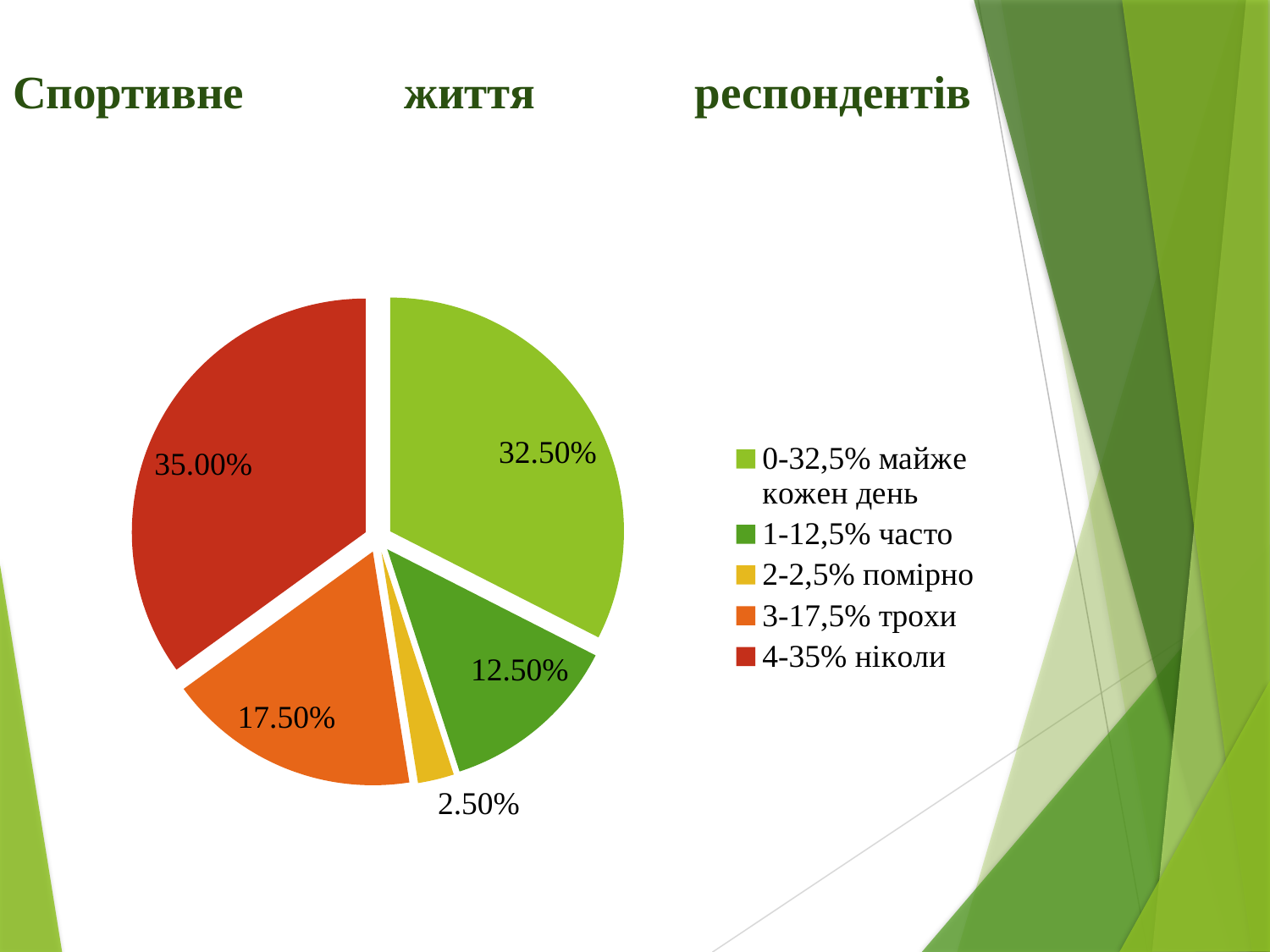
What kind of chart is shown on the slide? pie chart Which category has the largest slice of the pie? ніколи What is the difference between the "ніколи" slice and the "майже кожен день" slice? 2.50% What is the title of the slide containing the chart? Спортивне життя респондентів What is the value of the slice for "часто" (often)? 12.50% What is the value of the slice for "майже кожен день" (almost every day)? 32.50% How many slices does the pie chart have? 5 What is the value of the slice for "трохи" (a little)? 17.50% Which is larger, the slice for "трохи" or the slice for "часто"? трохи What is the value of the slice for "помірно" (moderately)? 2.50% Which category has the smallest slice of the pie? помірно What is the value of the slice for "ніколи" (never)? 35.00%